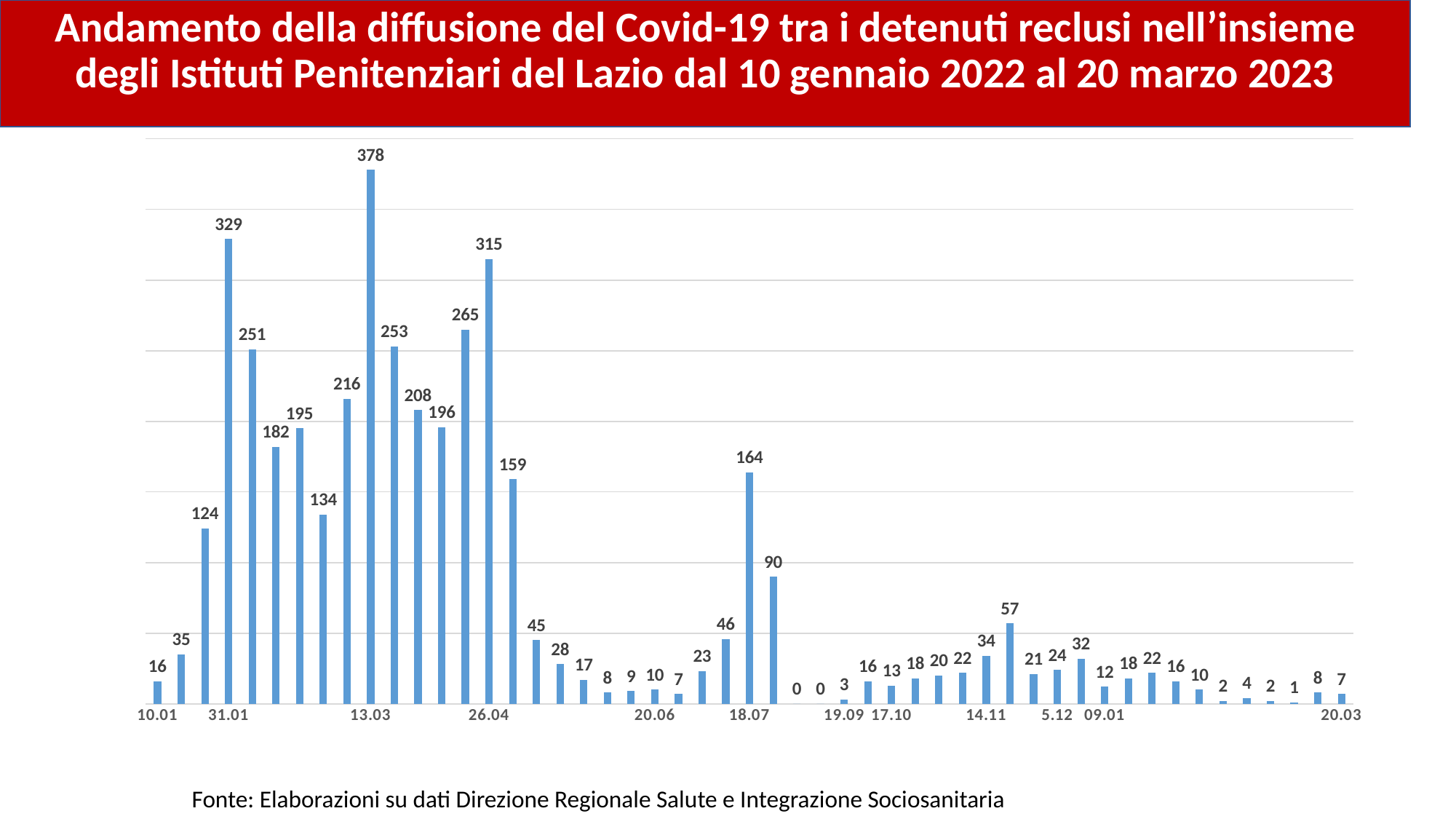
What is the value for 10.01? 16 What is the value for 26.04? 315 What source is cited below the chart? Elaborazioni su dati Direzione Regionale Salute e Integrazione Sociosanitaria What is the value for 13.03? 378 What is the value for 18.07? 164 What kind of chart is shown on the slide? bar chart What is the difference between the values for 13.03 and 31.01? 49 What is the value for 20.03? 7 Which date has the highest value? 13.03 Do the values rise or fall from 13.03 to 20.06? fall What is the highest value shown in the chart? 378 Which is larger, the value for 26.04 or the value for 18.07? 26.04